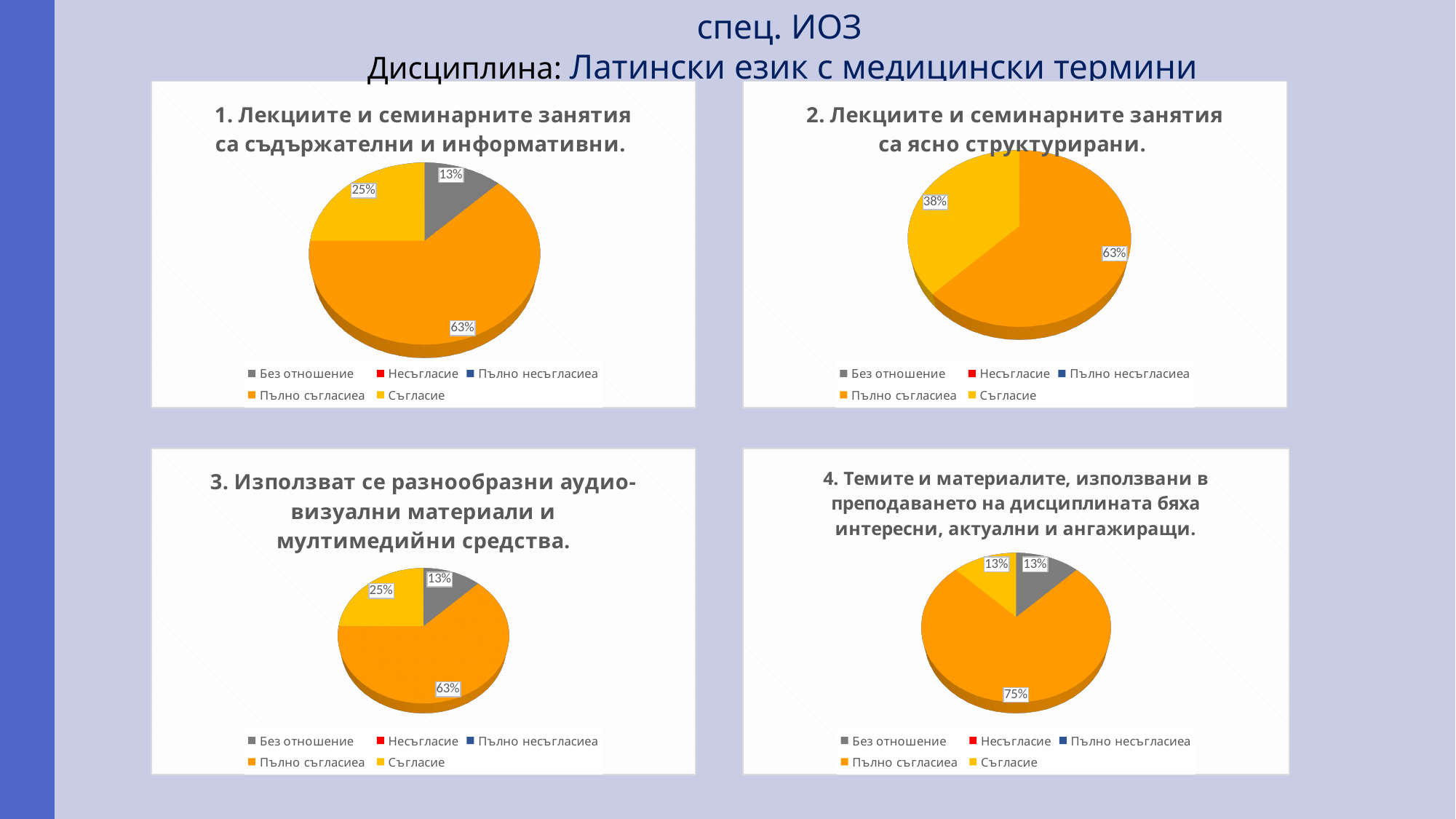
What type of chart is the bottom-right chart (4. Темите и материалите...)? Pie chart How many slices with data labels are visible in the top-right chart (2. Лекциите и семинарните занятия са ясно структурирани.)? 2 In the bottom-right chart (4. Темите и материалите...), what is the difference between the Пълно съгласиеа slice and the Без отношение slice? 62% In the top-right chart (2. Лекциите и семинарните занятия са ясно структурирани.), which category has the largest slice? Пълно съгласиеа In the bottom-left chart (3. Използват се разнообразни аудио-визуални материали...), which category has the smallest slice? Без отношение In the top-left chart (1. Лекциите и семинарните занятия са съдържателни и информативни.), what percentage is shown for Пълно съгласиеа? 63% In the bottom-left chart (3. Използват се разнообразни аудио-визуални материали...), what is the difference between the Пълно съгласиеа slice and the Съгласие slice? 38% In the top-left chart (1. Лекциите и семинарните занятия са съдържателни и информативни.), which is larger: Съгласие or Без отношение? Съгласие In the top-left chart (1. Лекциите и семинарните занятия са съдържателни и информативни.), what percentage is shown for Съгласие? 25% How many entries does the legend of the top-right chart (2. Лекциите и семинарните занятия са ясно структурирани.) list? 5 In the bottom-right chart (4. Темите и материалите...), what percentage is shown for Пълно съгласиеа? 75% In the top-right chart (2. Лекциите и семинарните занятия са ясно структурирани.), what percentage is shown for Съгласие? 38%